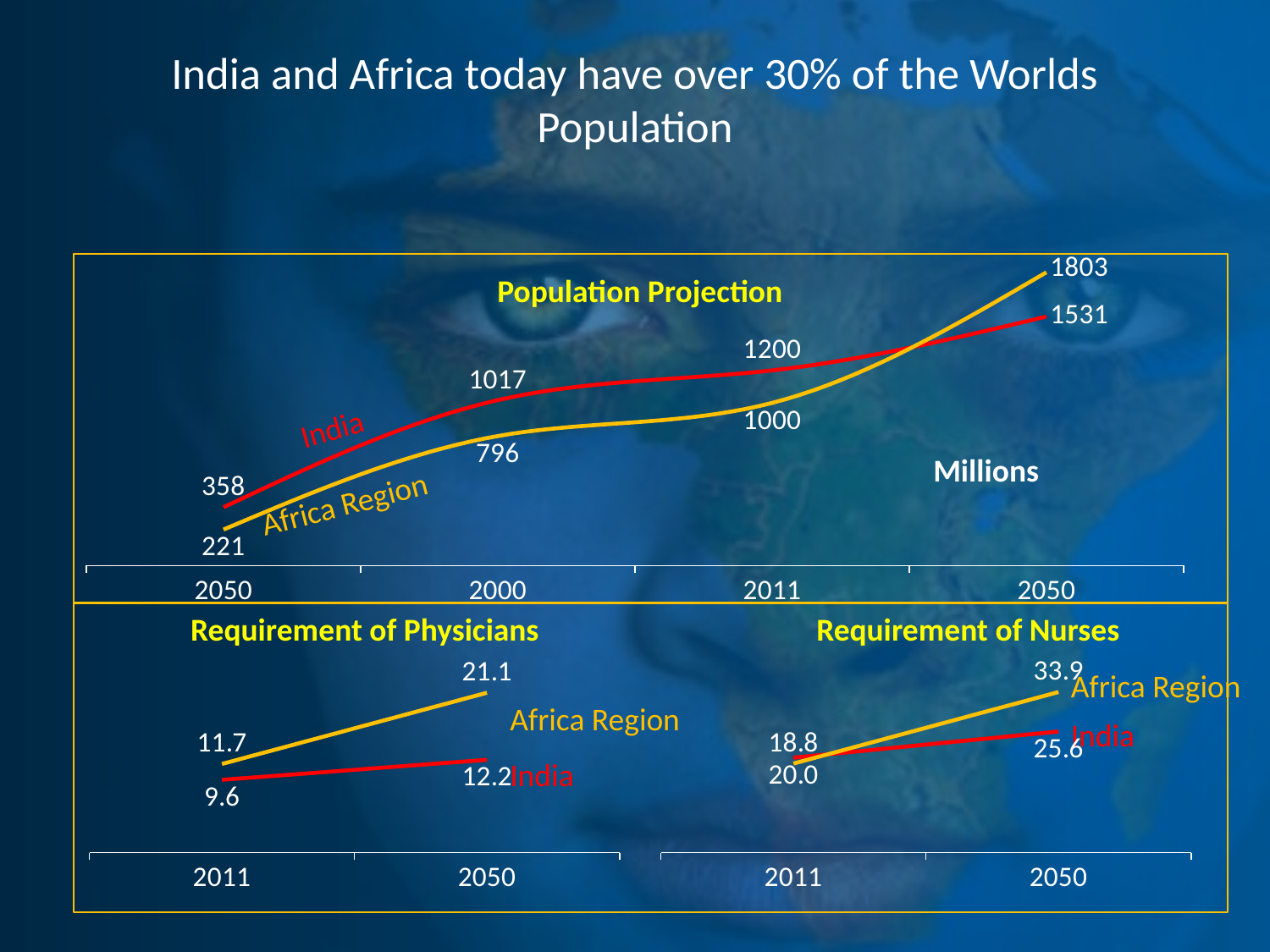
In the Population Projection chart, what is the value for India in 2000? 1017 In the Population Projection chart, what is the difference between India and Africa Region in 2000? 221 In the Population Projection chart, which is larger in 2011, India or Africa Region? India In the Requirement of Physicians chart, what is the difference between the Africa Region values for 2050 and 2011? 9.4 In the Requirement of Physicians chart, what is the value for India in 2011? 9.6 In the Population Projection chart, what is the value for Africa Region in 2011? 1000 In the Population Projection chart, what is the highest value shown for Africa Region? 1803 What kind of chart is the Population Projection chart? line chart In the Requirement of Nurses chart, what is the value for Africa Region in 2050? 33.9 In the Population Projection chart, does the India line rise or fall from left to right? rise In the Requirement of Physicians chart, what is the value for Africa Region in 2050? 21.1 In the Requirement of Nurses chart, which is larger in 2050, India or Africa Region? Africa Region